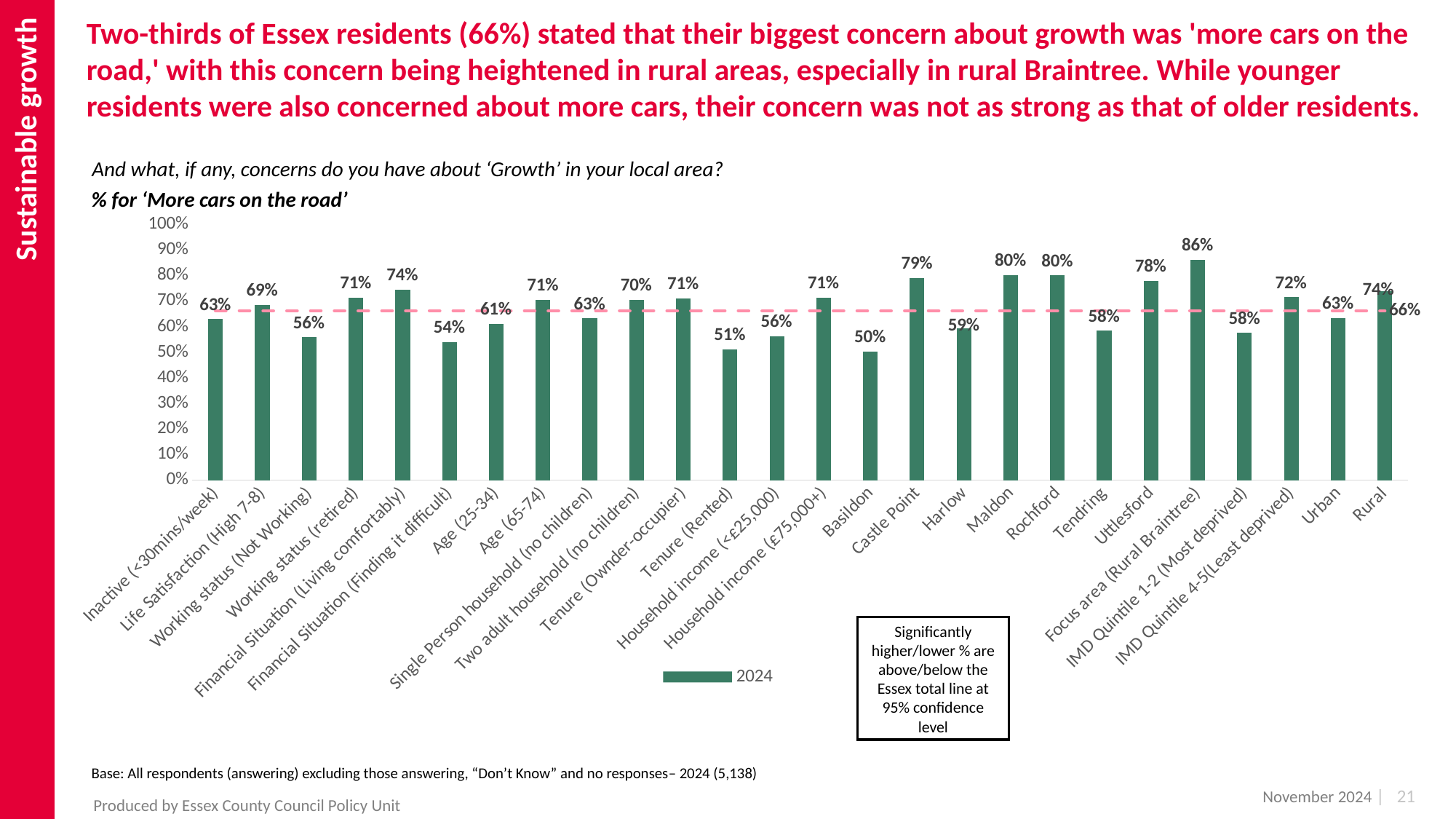
Which category has the highest value? Focus area (Rural Braintree) What is the difference between the values for Rural and Urban? 11% How many categories are shown on the x axis? 26 What is the value for Focus area (Rural Braintree)? 86% Which category has the lowest value? Basildon What is the value for Castle Point? 79% What value does the dashed horizontal line represent? 66% Is the value for Harlow greater or less than 70%? less How many series does the legend list? 1 What is the difference between the values for Age (65-74) and Age (25-34)? 10% Which is larger, the value for Household income (£75,000+) or Household income (<£25,000)? Household income (£75,000+) What is the value for Tenure (Rented)? 51%